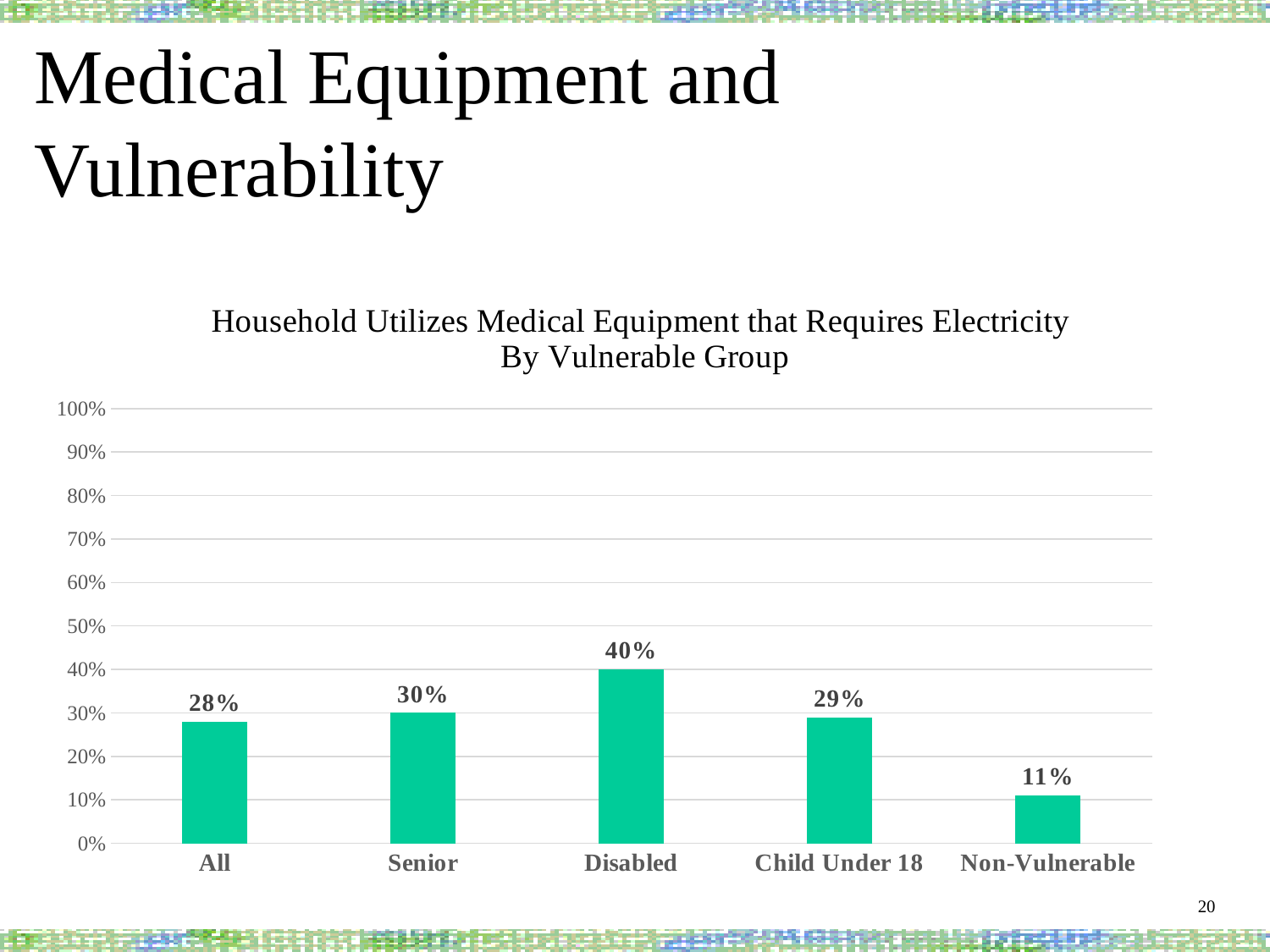
What is the difference between the values for Disabled and Non-Vulnerable? 29% What is the value for Non-Vulnerable? 11% What kind of chart is shown? bar chart How many groups are shown on the x axis? 5 Which group has the lowest value? Non-Vulnerable Is the value for Disabled greater or less than 50%? less What is the value for Child Under 18? 29% What is the value for Disabled? 40% What is the difference between the values for Senior and All? 2% Which group has the highest value? Disabled Which is larger, the value for Disabled or the value for Senior? Disabled What is the value for Senior? 30%